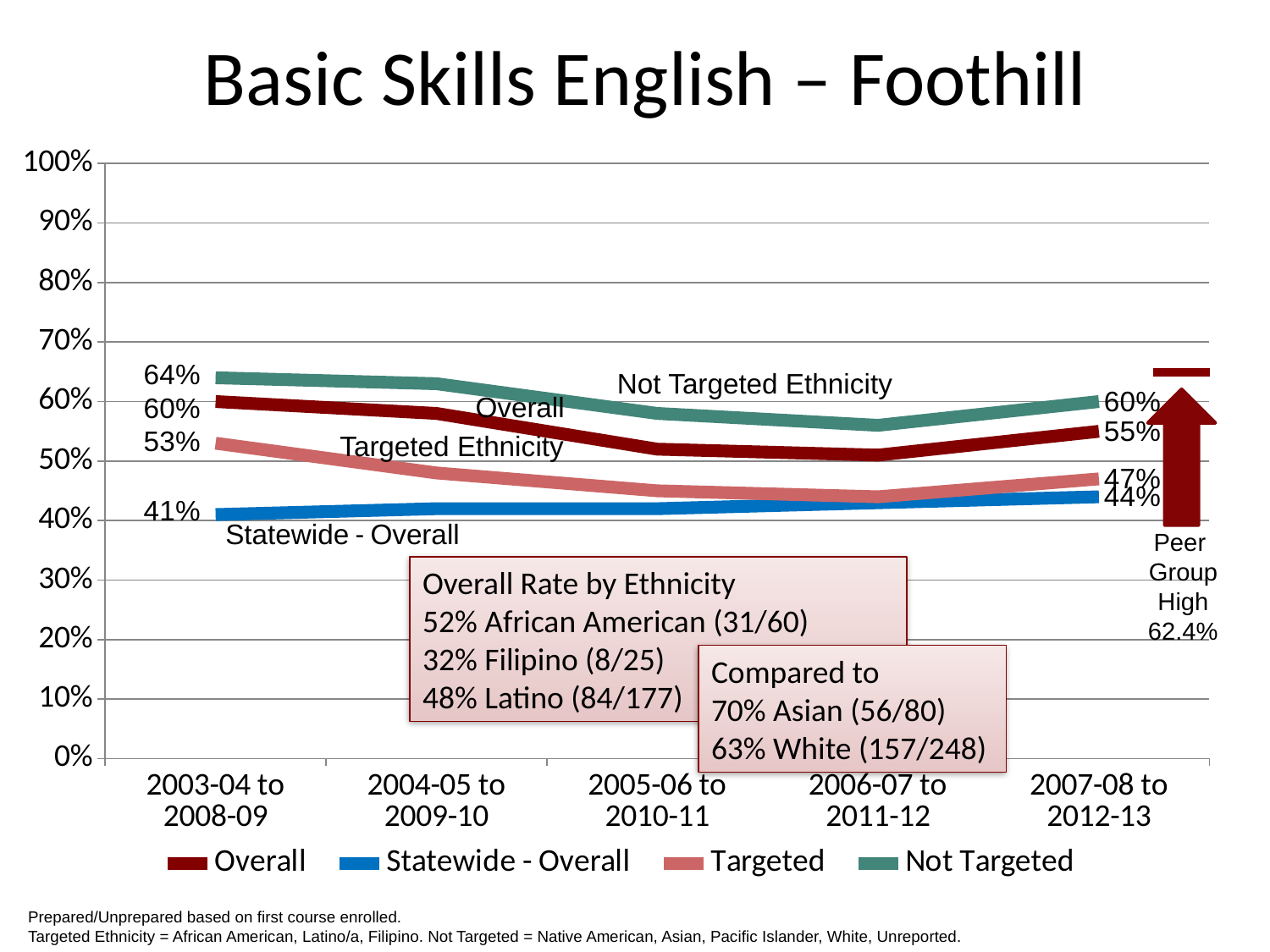
What is the difference between the Overall value and the Targeted value in 2003-04 to 2008-09? 7% How many series does the legend list? 4 What is the Statewide - Overall value for 2003-04 to 2008-09? 41% What is the Not Targeted value for 2003-04 to 2008-09? 64% Which series has the highest value in 2003-04 to 2008-09? Not Targeted What is the Overall value for 2007-08 to 2012-13? 55% Is the Overall value for 2006-07 to 2011-12 greater or less than 60%? less Which series has the lowest value in 2007-08 to 2012-13? Statewide - Overall How many time periods are shown on the x axis? 5 What type of chart is shown on the slide? line chart Does the Statewide - Overall series rise or fall from 2003-04 to 2008-09 to 2007-08 to 2012-13? rise What is the Targeted value for 2007-08 to 2012-13? 47%